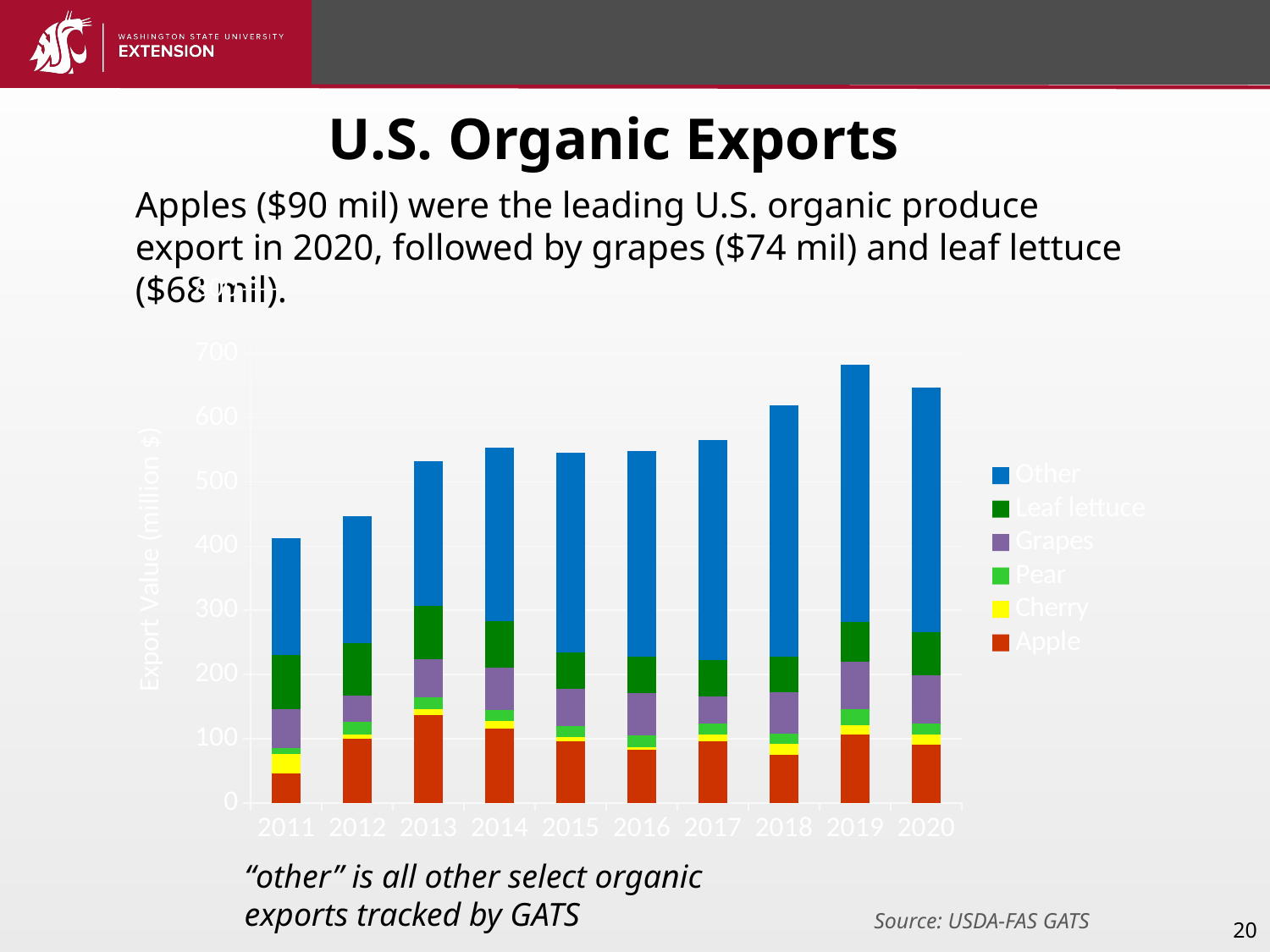
Which year has a larger total export value, 2017 or 2018? 2018 Which year has the lowest total export value in the chart? 2011 Which series appears at the bottom of each stacked bar? Apple What is the label on the chart's y axis? Export Value (million $) Which year has the highest total export value in the chart? 2019 Is the total export value for 2019 greater or less than 600? greater How many series does the chart's legend list? 6 What kind of chart is shown on the slide? bar chart Is the total export value for 2011 greater or less than 500? less How many years are shown along the x axis of the chart? 10 Is the total export value for 2012 greater or less than 500? less Do the total export values generally rise or fall from 2011 to 2019? rise